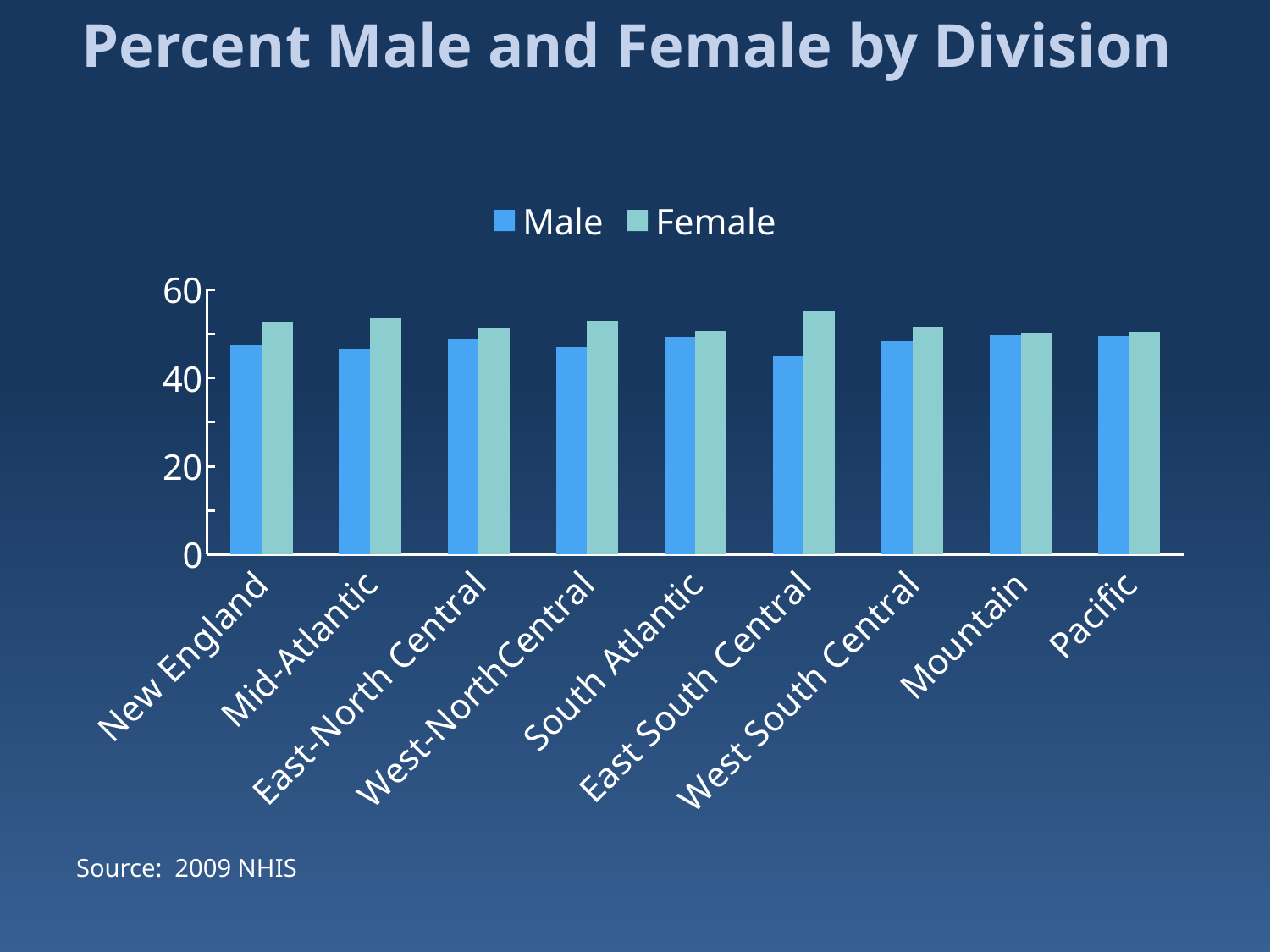
What is the title of the chart? Percent Male and Female by Division Is the Male value for East South Central greater or less than 40? greater Which division has the highest Female value? East South Central Is the Male value for New England greater or less than 40? greater Is the Female value for East South Central greater or less than 60? less How many series does the legend list? 2 In East South Central, which is larger, the Male value or the Female value? Female Which division has the lowest Male value? East South Central How many divisions are shown along the x axis? 9 What are the two series named in the legend? Male and Female What kind of chart is shown on the slide? bar chart